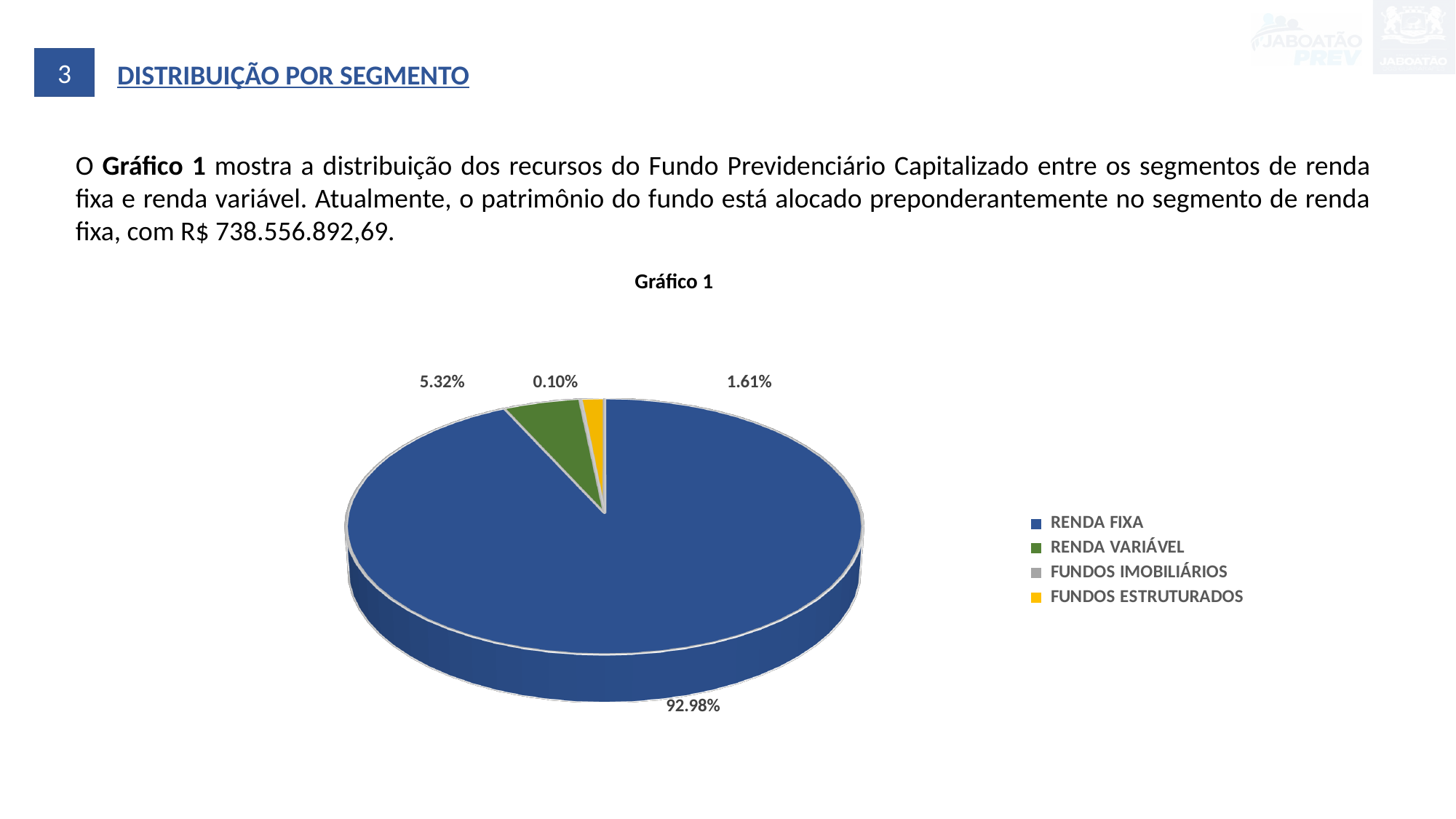
What type of chart is Gráfico 1? pie chart Which category has the largest slice of the pie? RENDA FIXA Which is larger, the share of RENDA VARIÁVEL or the share of FUNDOS ESTRUTURADOS? RENDA VARIÁVEL What share of the pie does RENDA FIXA represent? 92.98% What share of the pie does FUNDOS ESTRUTURADOS represent? 1.61% What share of the pie does FUNDOS IMOBILIÁRIOS represent? 0.10% Which category has the smallest slice of the pie? FUNDOS IMOBILIÁRIOS How many categories does the legend of the pie chart list? 4 What is the difference in percentage points between the RENDA VARIÁVEL share and the FUNDOS ESTRUTURADOS share? 3.71% What is the title of the chart? Gráfico 1 What colour is the RENDA FIXA slice in the pie chart? blue